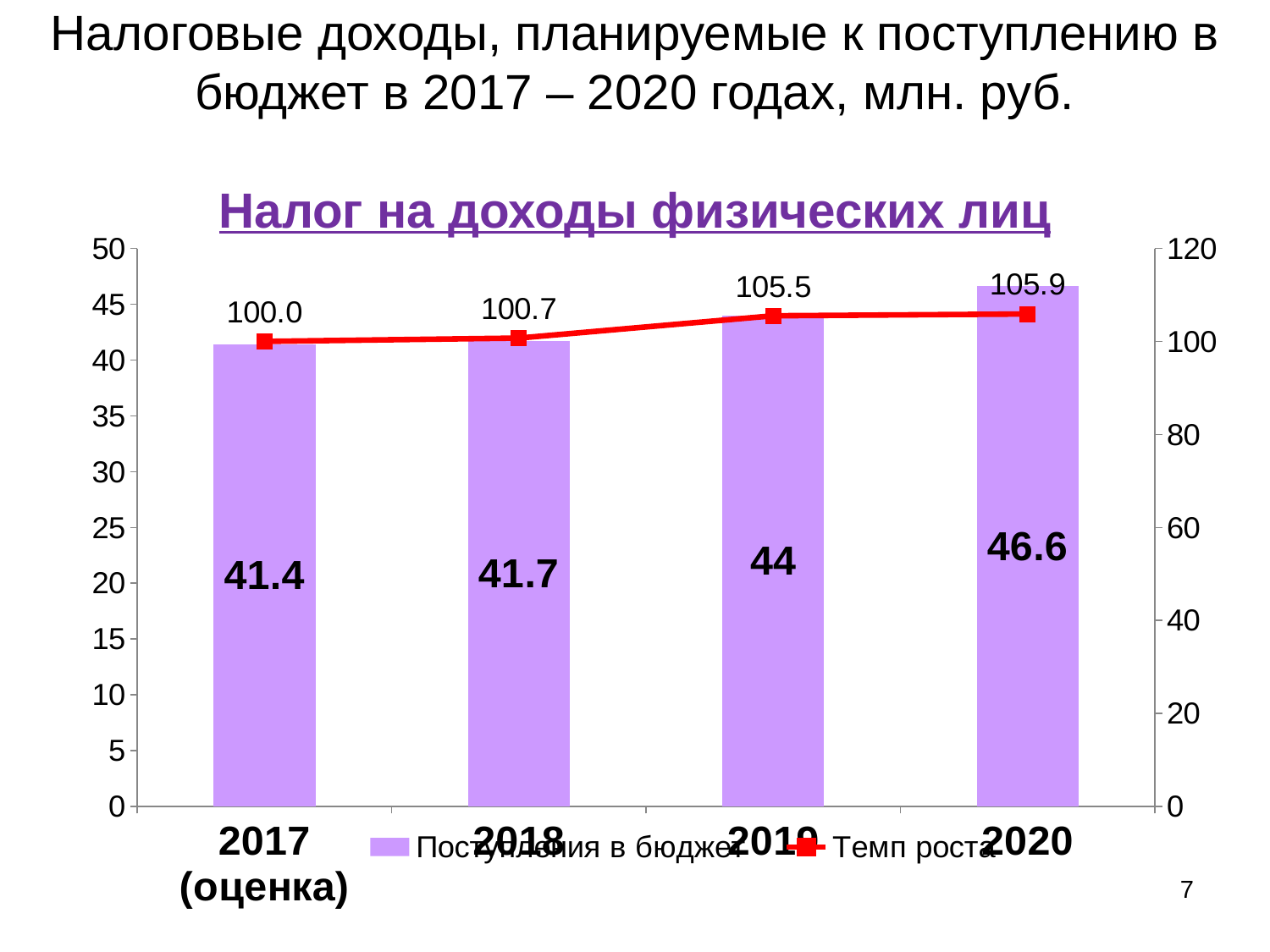
What is the title of the chart? Налог на доходы физических лиц Which year has the lowest value of Поступления в бюджет? 2017 (оценка) What is the Темп роста value for 2019? 105.5 How many years are shown on the x axis? 4 What is the difference between the Поступления в бюджет values for 2020 and 2019? 2.6 Which is larger, the Темп роста value for 2018 or for 2020? 2020 Which year has the highest value of Поступления в бюджет? 2020 How many series does the legend list? 2 Do the Поступления в бюджет values rise or fall from 2017 to 2020? rise What is the Темп роста value for 2017 (оценка)? 100.0 What is the value of Поступления в бюджет for 2020? 46.6 What is the value of Поступления в бюджет for 2018? 41.7